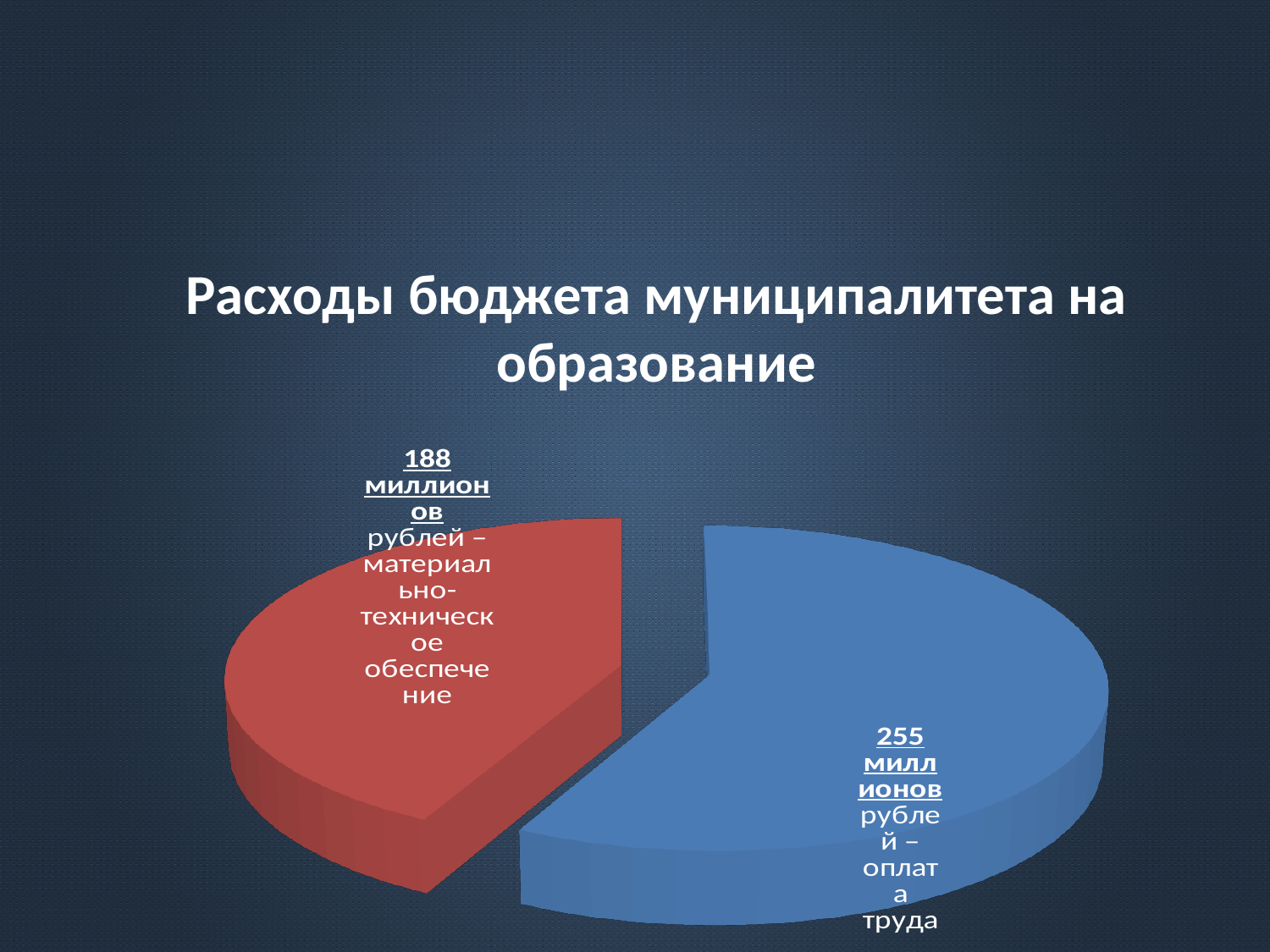
What colour is the slice representing оплата труда? Blue How many million rubles are spent on материально-техническое обеспечение? 188 миллионов What is the total of the two categories shown in the pie chart, in million rubles? 443 миллиона Which category has the smallest share of the pie? Материально-техническое обеспечение How many million rubles are spent on оплата труда? 255 миллионов What is the title of the chart on the slide? Расходы бюджета муниципалитета на образование What kind of chart is shown on the slide? Pie chart How many slices does the pie chart have? 2 Which is larger: spending on оплата труда or on материально-техническое обеспечение? Оплата труда By how many million rubles does spending on оплата труда exceed spending on материально-техническое обеспечение? 67 миллионов Which category has the largest share of the pie? Оплата труда